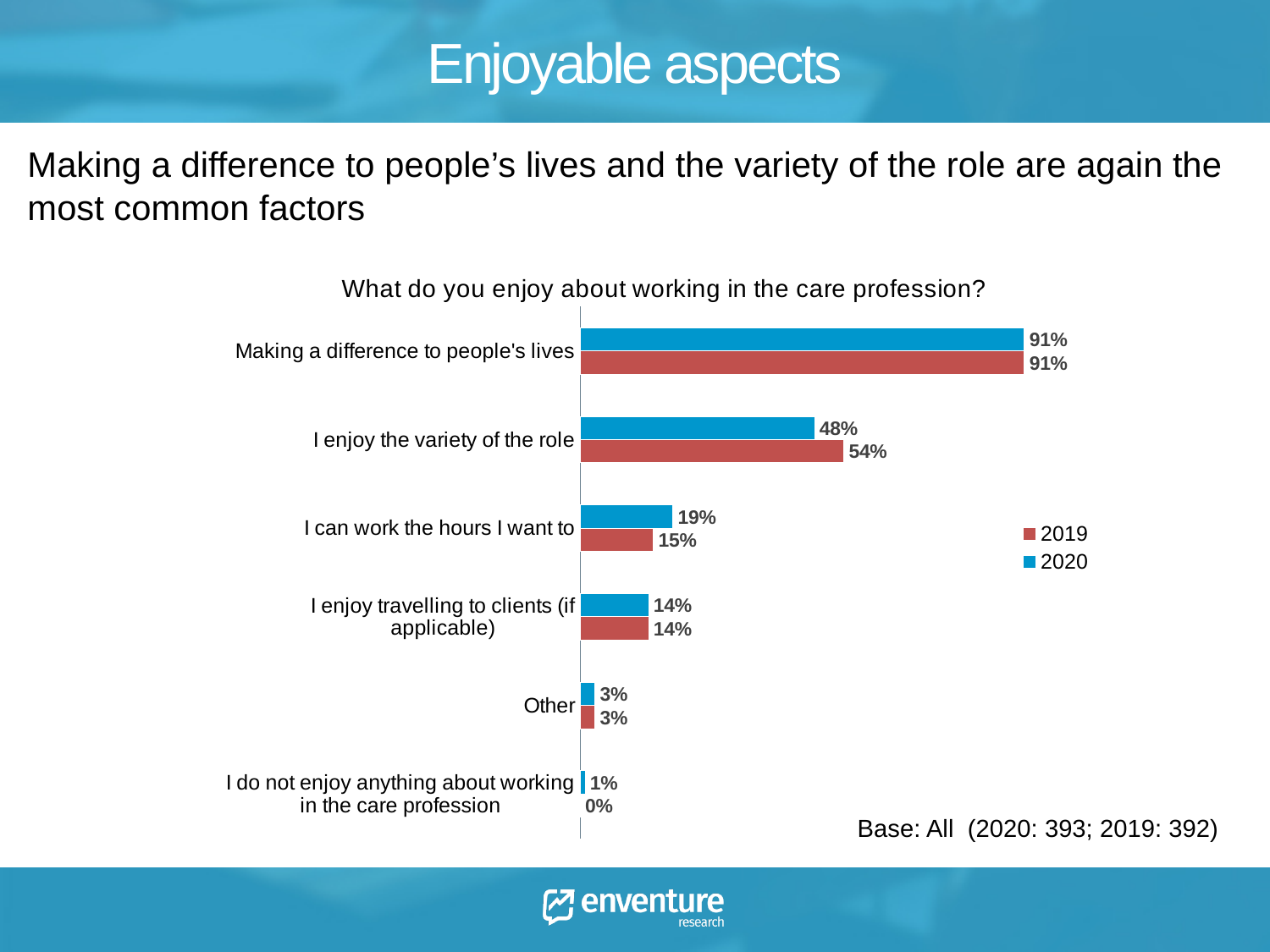
Which colour represents the 2019 series in the legend? Red How many series does the legend list? 2 What kind of chart is shown on the slide? Bar chart Which category has the highest value for 2020? Making a difference to people's lives What is the 2020 value for "I enjoy the variety of the role"? 48% What is the 2020 value for "I do not enjoy anything about working in the care profession"? 1% For "I can work the hours I want to", which year has the larger value, 2019 or 2020? 2020 What is the title of the chart? What do you enjoy about working in the care profession? How many categories are shown on the chart? 6 Which category has the lowest value for 2019? I do not enjoy anything about working in the care profession What is the difference between the 2019 and 2020 values for "I enjoy the variety of the role"? 6% What is the 2019 value for "I can work the hours I want to"? 15%